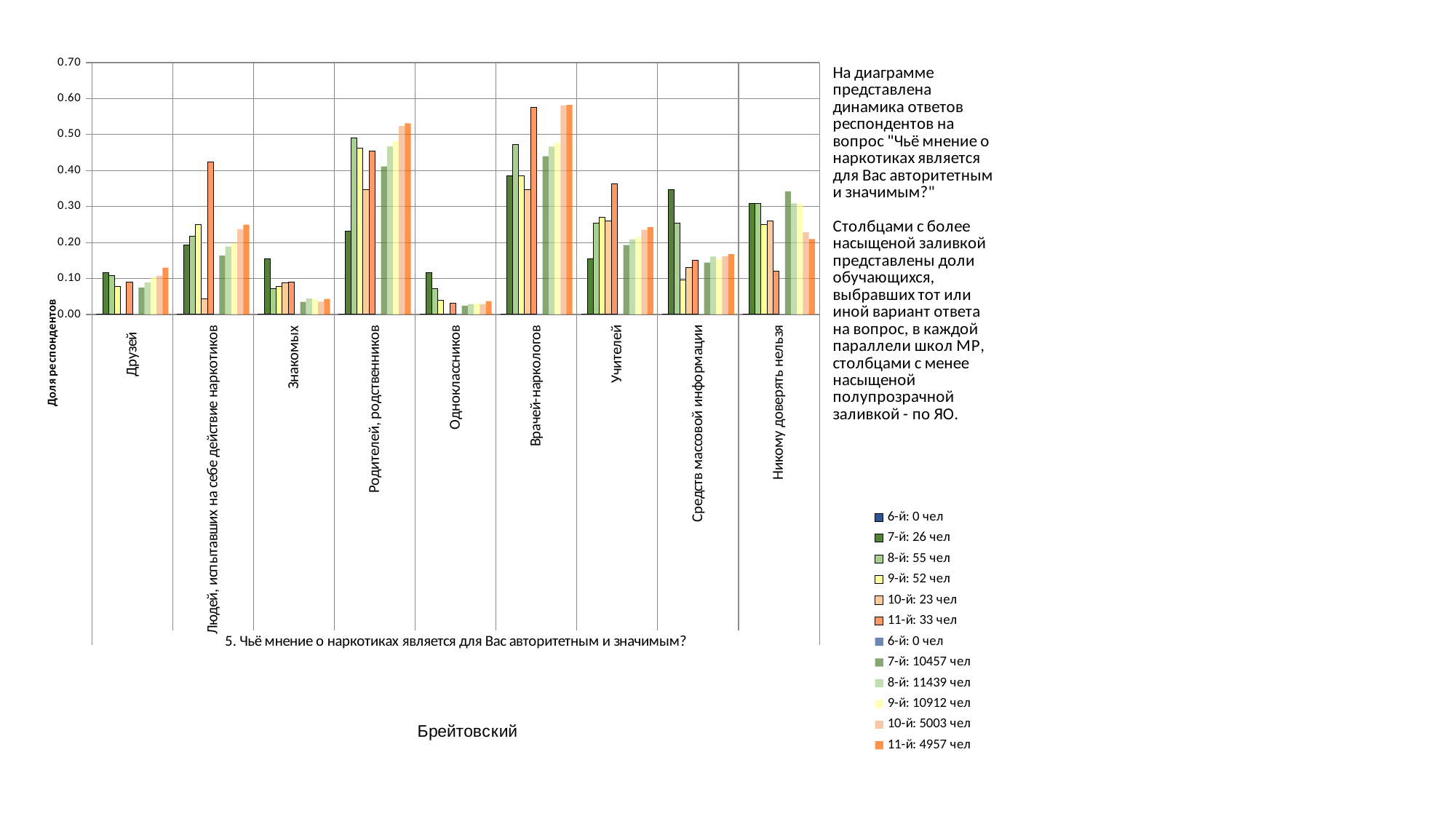
What is the title of the vertical axis of the chart? Доля респондентов What district name is shown as the title below the chart? Брейтовский Is the value of the '7-й: 26 чел' series for 'Знакомых' greater or less than 0.10? greater Which category contains the tallest bar in the chart? Врачей-наркологов Is the value of the '11-й: 33 чел' series for 'Врачей-наркологов' greater or less than 0.50? greater How many answer categories are shown along the x axis of the chart? 9 Which is larger for the '11-й: 33 чел' series: the value for 'Врачей-наркологов' or the value for 'Друзей'? Врачей-наркологов Is the value of the '7-й: 26 чел' series for 'Средств массовой информации' greater or less than 0.30? greater What kind of chart is shown on the slide? bar chart How many series does the chart legend list? 12